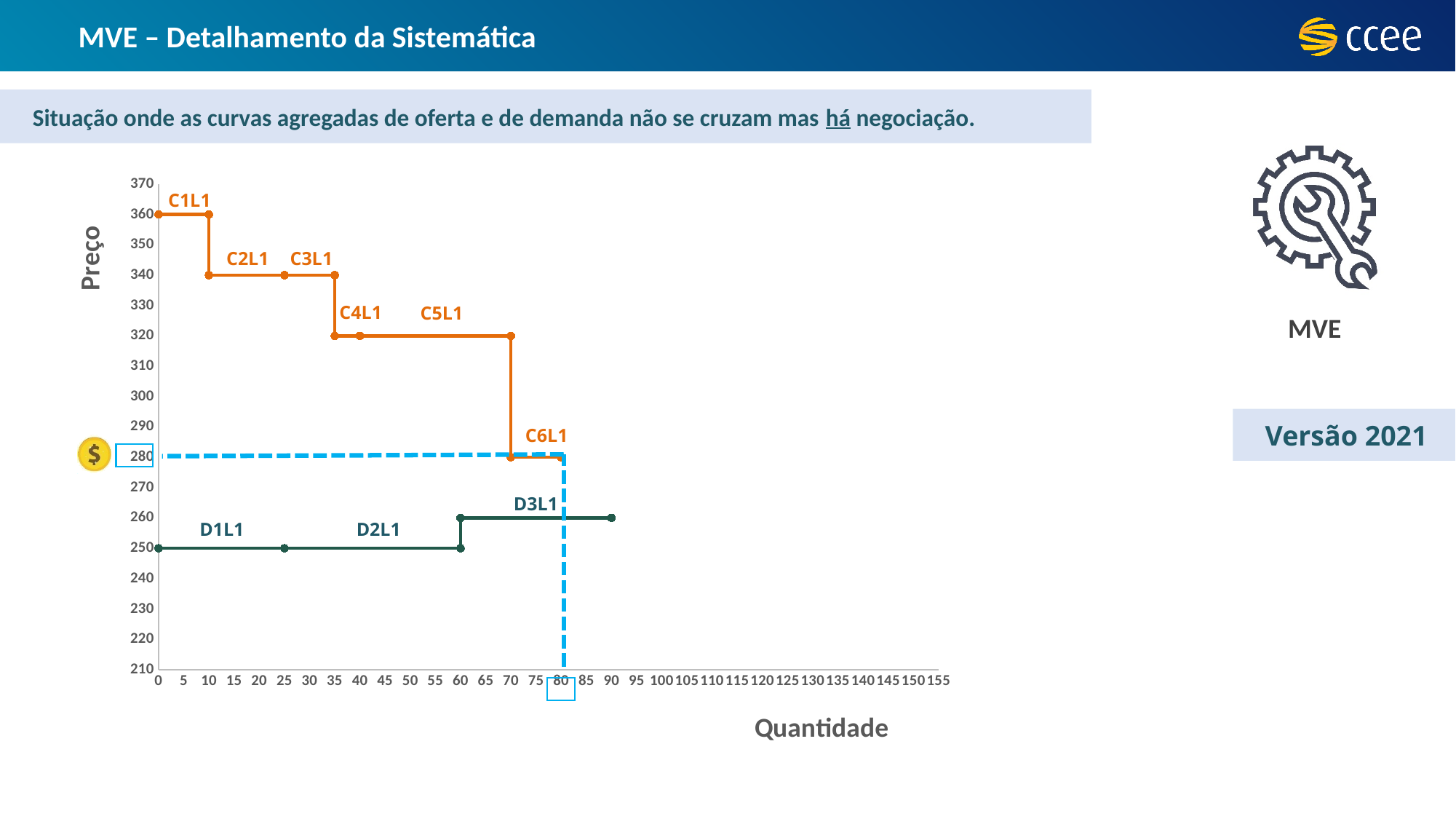
How many labelled segments make up the dark green demand curve? 3 At what quantity does the vertical dashed blue line meet the x axis? 80 What kind of chart is shown on the slide? Line chart (step curves) Which is at a higher price, segment C4L1 or segment D3L1? C4L1 Does the orange supply curve rise or fall as quantity increases? Fall Which supply segment is at the lowest price? C6L1 What price level does the demand segment D3L1 sit at? 260 Which supply segment is at the highest price? C1L1 How many labelled segments make up the orange supply curve? 6 What is the difference in price between segment C1L1 and segment C6L1? 80 What price level does the supply segment C6L1 sit at? 280 What price level does the supply segment C1L1 sit at? 360